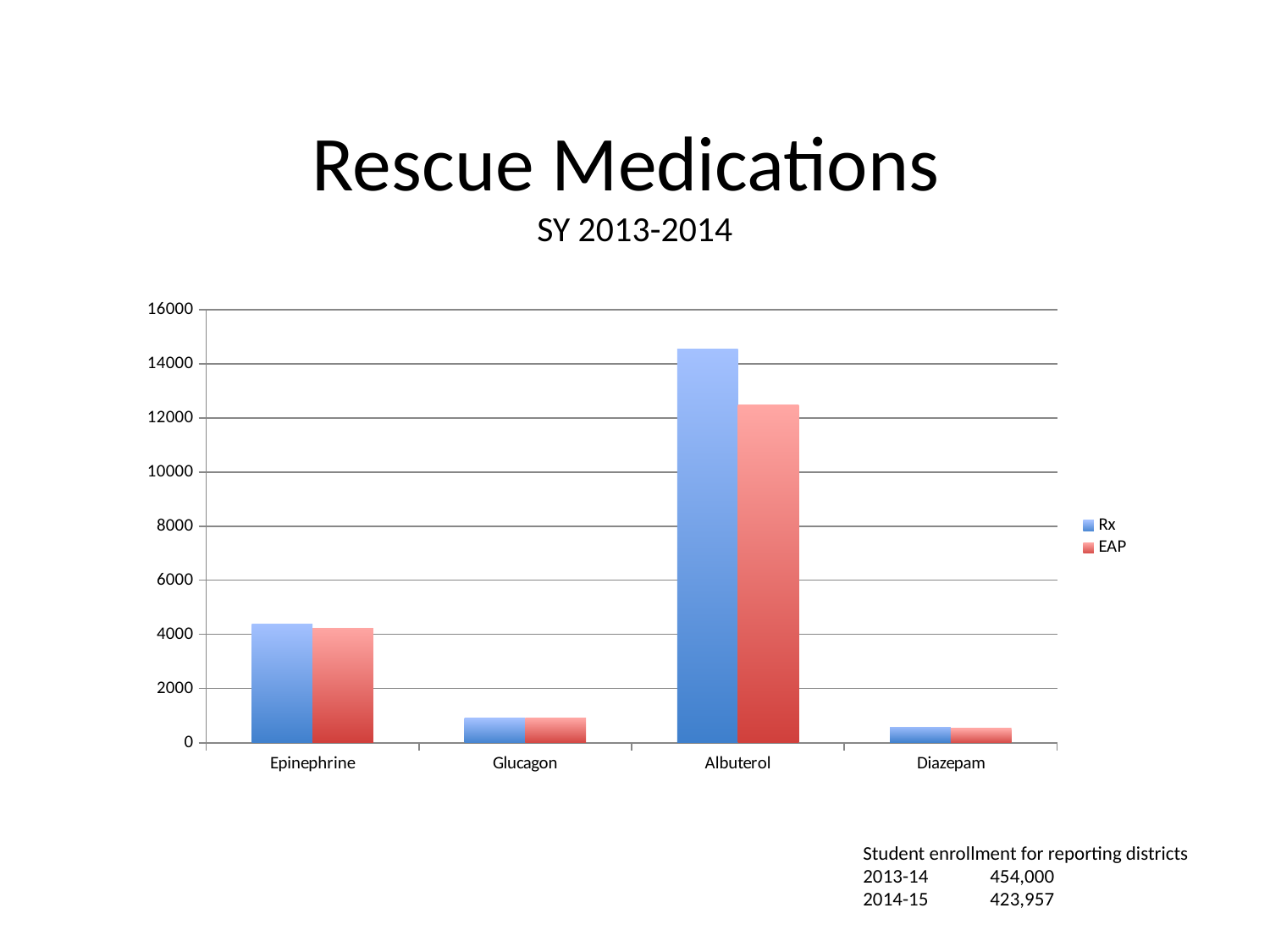
What are the two series named in the legend? Rx and EAP Which medication has the highest Rx value? Albuterol How many series does the legend list? 2 For Albuterol, which is larger, the Rx value or the EAP value? Rx What school year does the chart title refer to? SY 2013-2014 Is the EAP value for Albuterol greater or less than 14000? less What kind of chart is shown on the slide? bar chart Is the Rx value for Glucagon greater or less than 2000? less Is the Rx value for Albuterol greater or less than 14000? greater Which medication has the lowest EAP value? Diazepam How many medication categories are shown on the x axis? 4